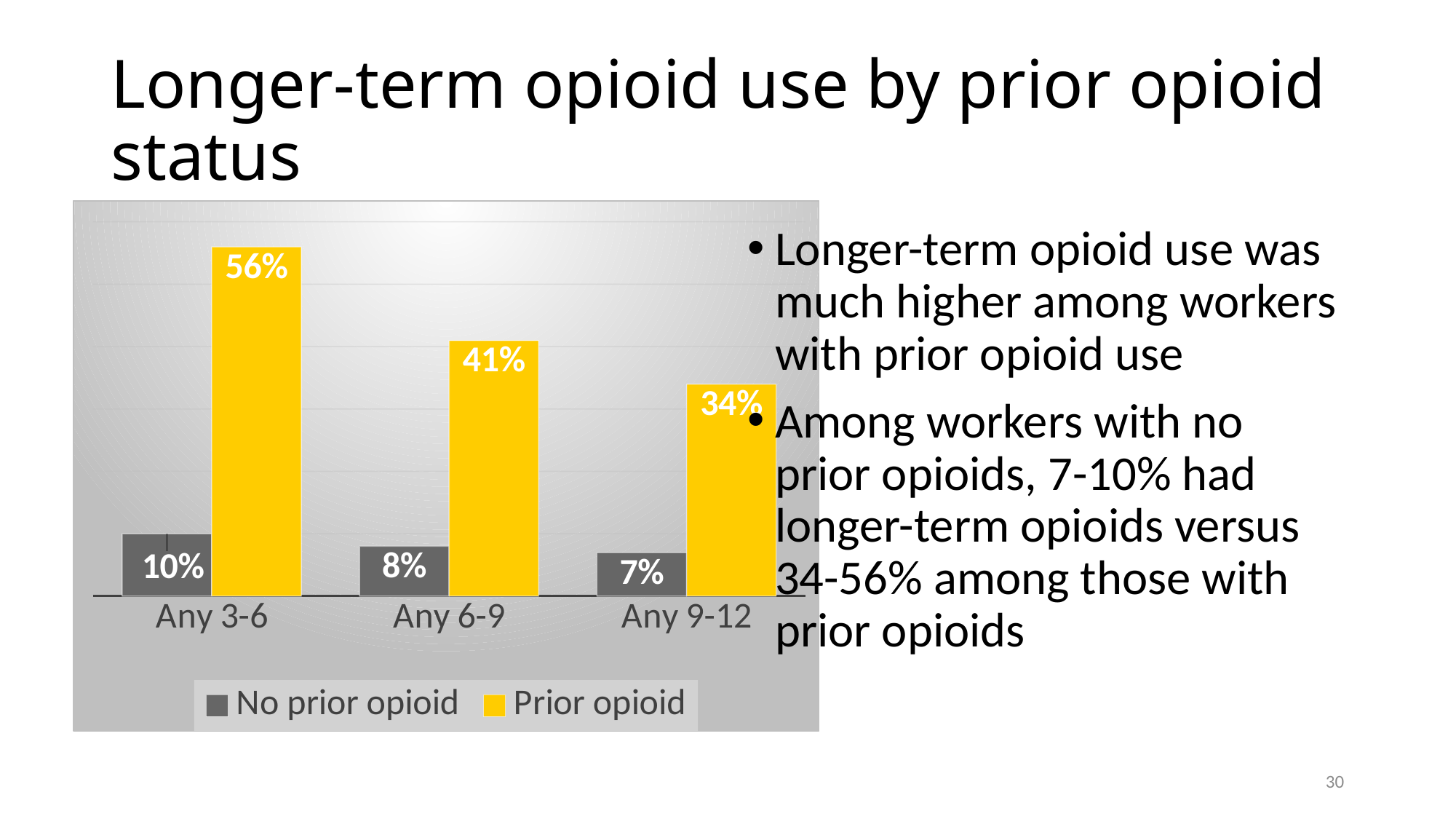
Do the Prior opioid values rise or fall from Any 3-6 to Any 9-12? Fall What kind of chart is shown on the slide? Bar chart What is the value for No prior opioid in the Any 6-9 category? 8% How many series does the legend list? 2 What is the value for No prior opioid in the Any 9-12 category? 7% Which category has the highest value for the Prior opioid series? Any 3-6 How many categories are shown on the x axis? 3 What is the value for Prior opioid in the Any 3-6 category? 56% Which category has the lowest value for the No prior opioid series? Any 9-12 Which is larger in the Any 9-12 category: Prior opioid or No prior opioid? Prior opioid What is the difference between the Prior opioid and No prior opioid values in the Any 3-6 category? 46% What is the value for Prior opioid in the Any 6-9 category? 41%